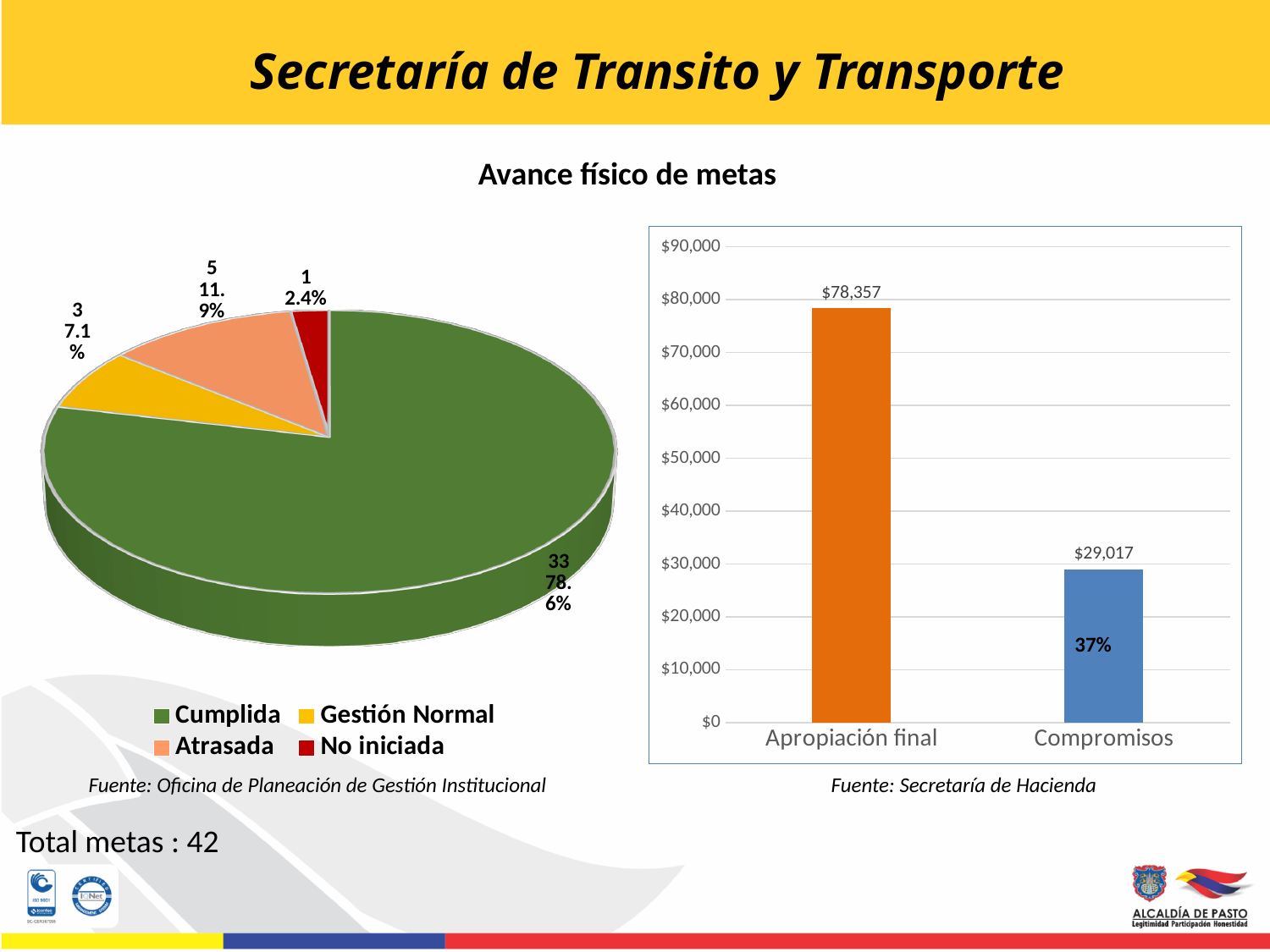
In the pie chart on the left, what percentage share does the Atrasada slice show? 11.9% In the bar chart on the right, what is the value for Compromisos? $29,017 In the pie chart on the left, how many metas are labelled Cumplida? 33 In the pie chart on the left, how many categories does the legend list? 4 In the pie chart on the left, which category has the largest slice? Cumplida In the bar chart on the right, what is the difference between Apropiación final and Compromisos? $49,340 In the pie chart on the left, which category has the smallest slice? No iniciada In the pie chart on the left, how many metas are labelled No iniciada? 1 In the bar chart on the right, what is the value for Apropiación final? $78,357 In the bar chart on the right, what percentage is printed on the Compromisos bar? 37% What kind of chart is shown on the right side of the slide? Bar chart In the pie chart on the left, what percentage share does the Cumplida slice show? 78.6%